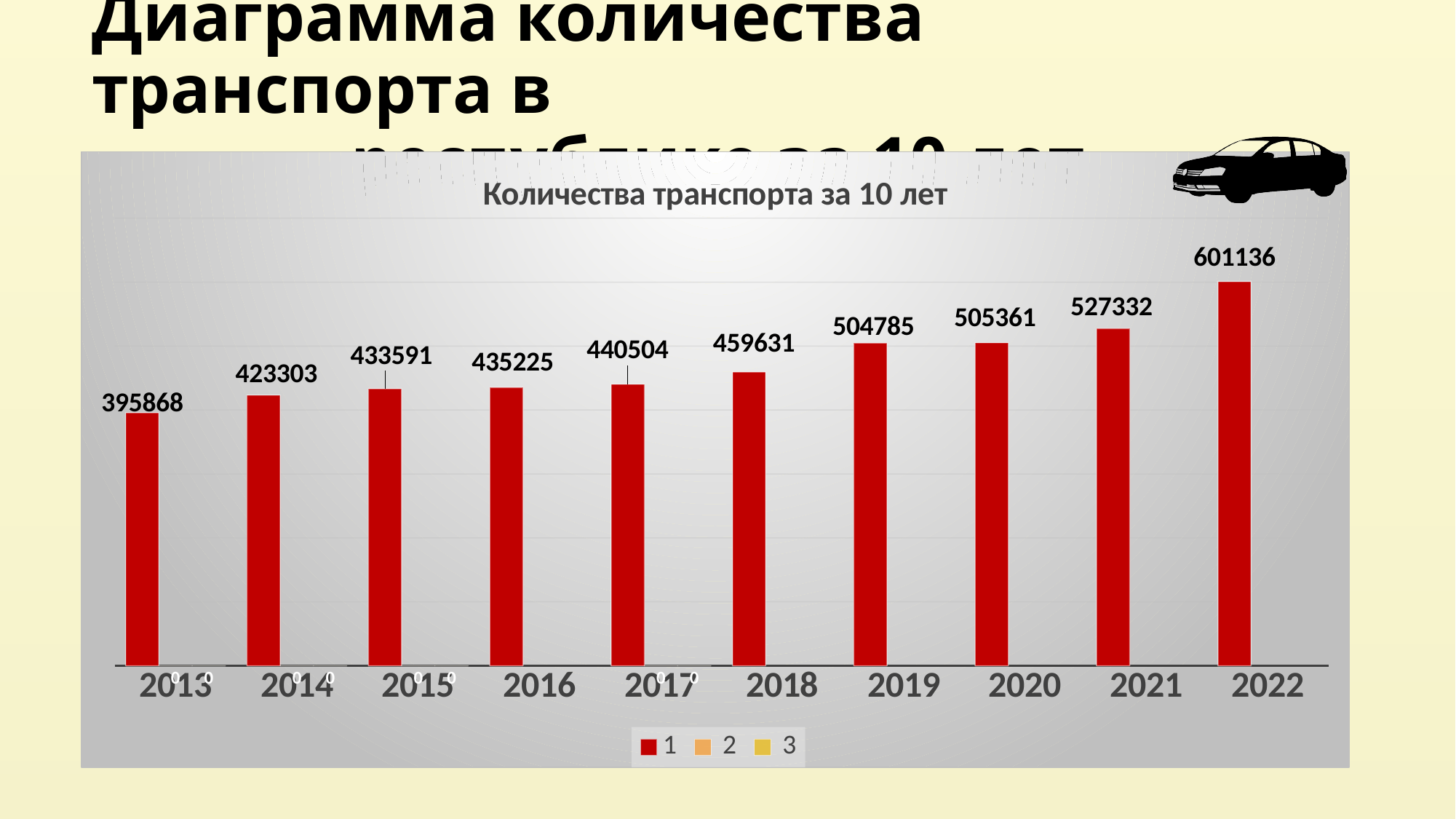
What is the difference between the values for 2022 and 2013? 205268 What is the value for 2013? 395868 What is the difference between the values for 2021 and 2020? 21971 Which is larger, the value for 2018 or the value for 2019? 2019 Which year has the lowest value? 2013 What type of chart is shown on the slide? bar chart How many years are shown on the x axis? 10 What is the value for 2018? 459631 How many series does the legend list? 3 Which year has the highest value? 2022 What is the value for 2021? 527332 What is the title of the chart? Количества транспорта за 10 лет